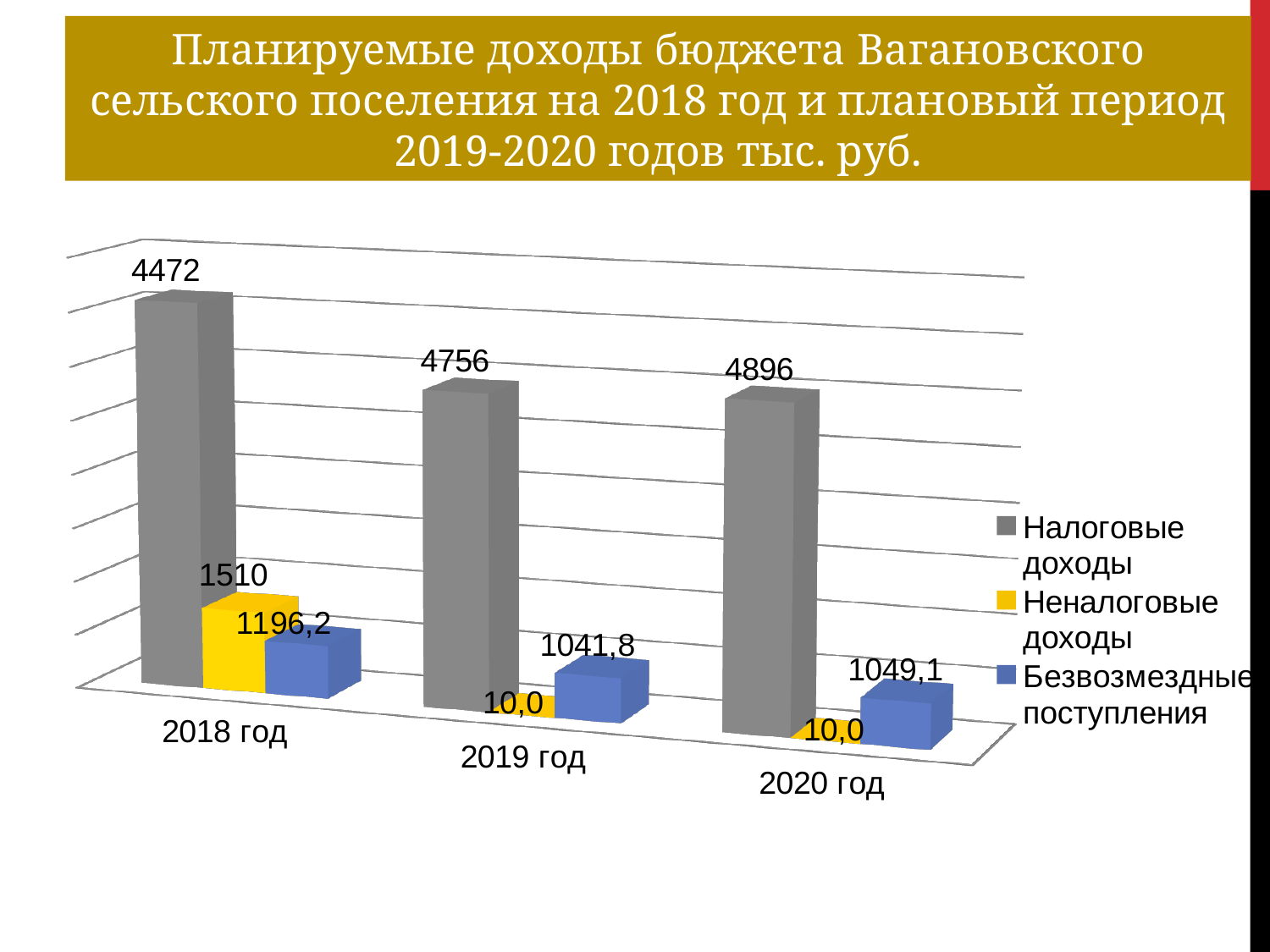
What is the value of Безвозмездные поступления for 2019 год? 1041,8 What is the difference between Неналоговые доходы and Безвозмездные поступления in 2018 год? 313,8 How many series does the legend list? 3 What is the value of Неналоговые доходы for 2018 год? 1510 Which is larger: Безвозмездные поступления in 2018 год or in 2020 год? 2018 год What is the difference between Налоговые доходы in 2020 год and 2019 год? 140 How many years (categories) are shown on the x axis? 3 What is the value of Налоговые доходы for 2018 год? 4472 What is the value of Неналоговые доходы for 2020 год? 10,0